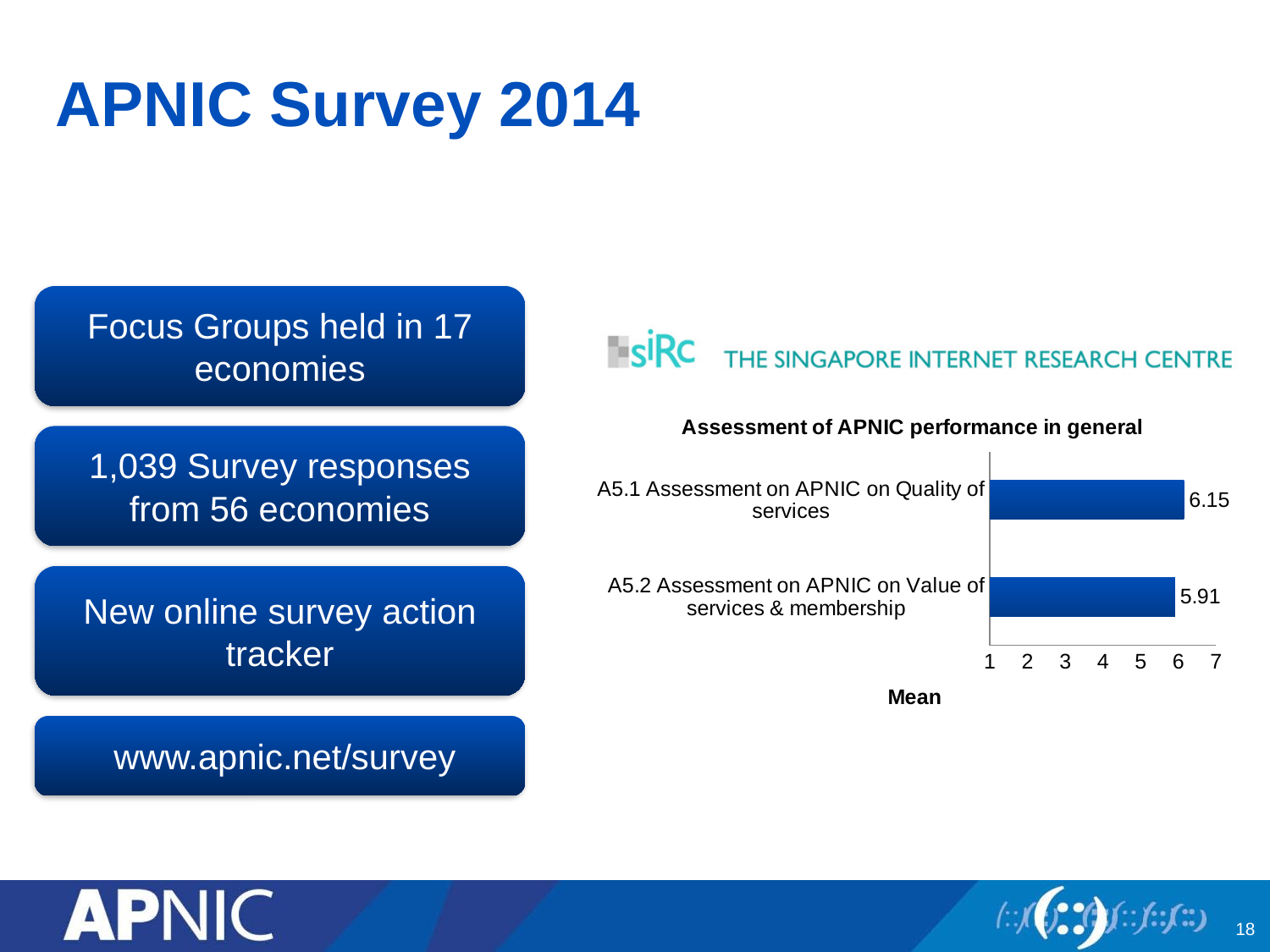
Which category has the highest mean value? A5.1 Assessment on APNIC on Quality of services What is the title of the chart? Assessment of APNIC performance in general Which category has the lowest mean value? A5.2 Assessment on APNIC on Value of services & membership What is the mean value for A5.2 Assessment on APNIC on Value of services & membership? 5.91 How many categories are shown in the chart? 2 Which is larger: the mean for A5.1 Quality of services or the mean for A5.2 Value of services & membership? A5.1 Quality of services Is the mean value for A5.2 Value of services & membership greater or less than 6? less What kind of chart is shown on the slide? Bar chart Is the mean value for A5.1 Quality of services greater or less than 6? greater What is the label of the horizontal axis of the chart? Mean What is the difference between the mean values for A5.1 Quality of services and A5.2 Value of services & membership? 0.24 What is the mean value for A5.1 Assessment on APNIC on Quality of services? 6.15